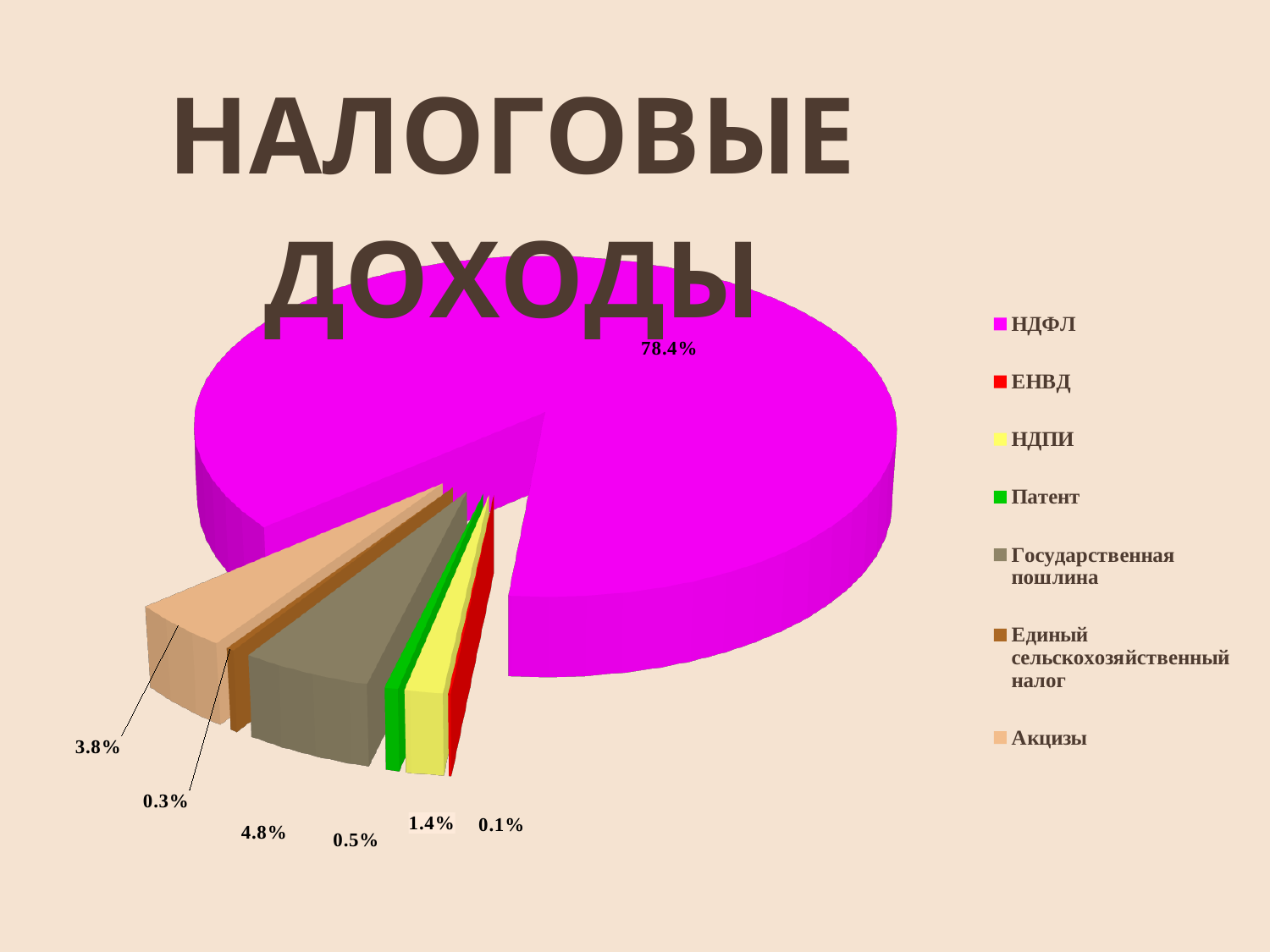
What percentage is shown for Акцизы? 3.8% Which category has the largest share of the pie? НДФЛ Which is larger, the share of Акцизы or the share of Государственная пошлина? Государственная пошлина What is the title of the slide? НАЛОГОВЫЕ ДОХОДЫ What is the difference between the shares of Государственная пошлина and Акцизы? 1.0% What kind of chart is shown on the slide? pie chart What colour is the НДФЛ slice in the pie chart? magenta Which category has the smallest share of the pie? ЕНВД What percentage is shown for Государственная пошлина? 4.8% What percentage is shown for НДФЛ? 78.4% What percentage is shown for Единый сельскохозяйственный налог? 0.3% How many categories does the legend of the pie chart list? 7